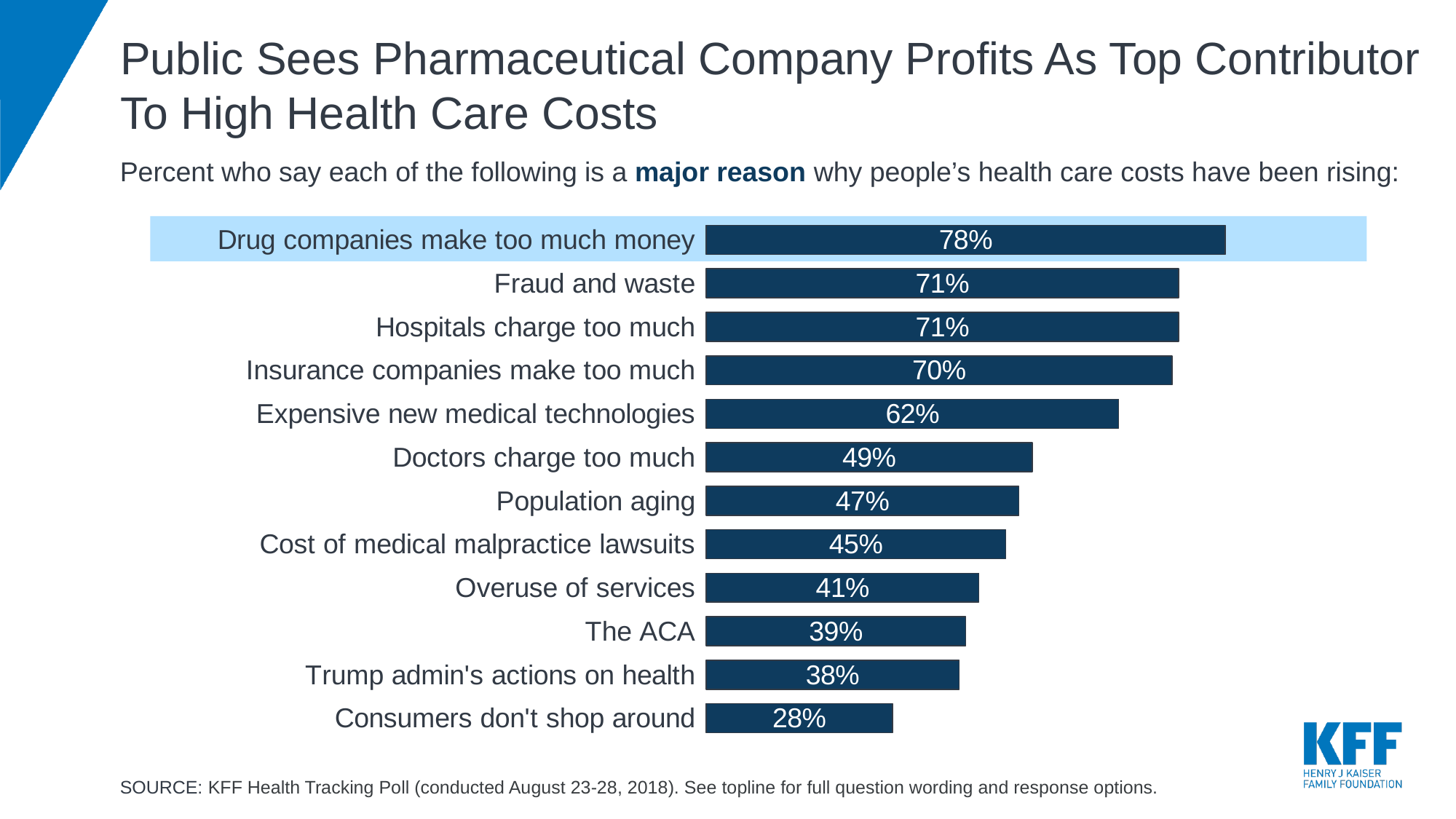
Which reason has the lowest percentage? Consumers don't shop around What percent say 'Consumers don't shop around' is a major reason? 28% Which bar is highlighted with a light blue background? Drug companies make too much money What is the value for 'The ACA'? 39% What is the difference between 'Drug companies make too much money' and 'Consumers don't shop around'? 50 percentage points What percent say drug companies making too much money is a major reason for rising health care costs? 78% Which reason has the highest percentage? Drug companies make too much money What kind of chart is shown on the slide? Bar chart What is the difference between 'Doctors charge too much' and 'Population aging'? 2 percentage points Which is larger: the value for 'Overuse of services' or the value for 'Trump admin's actions on health'? Overuse of services How many reasons are shown in the chart? 12 What is the value for 'Expensive new medical technologies'? 62%